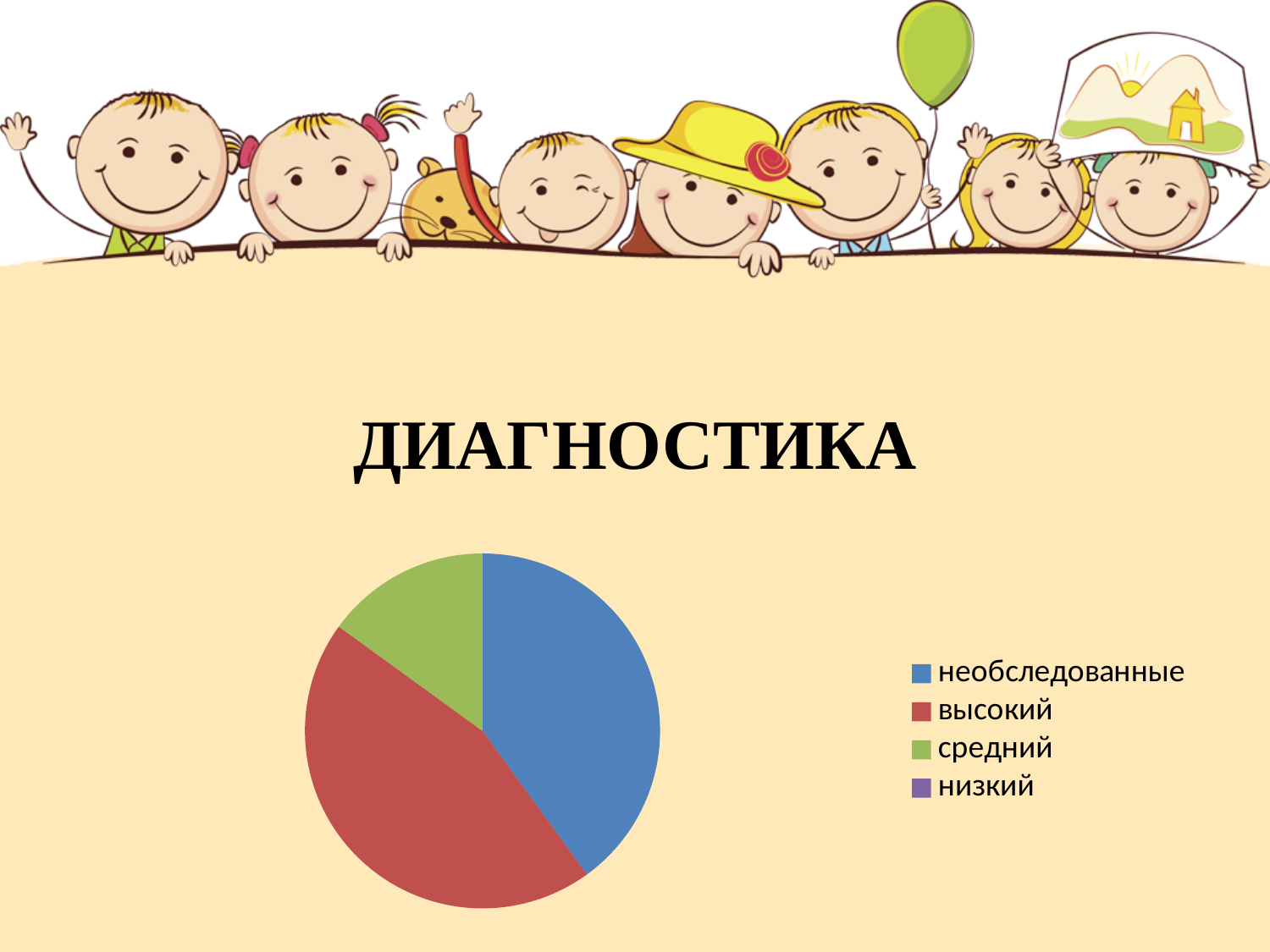
How many categories does the legend of the pie chart list? 4 What kind of chart is shown on the slide? pie chart Which is larger in the pie chart, the slice for необследованные or the slice for средний? необследованные What is the title shown above the pie chart? ДИАГНОСТИКА Which is larger in the pie chart, the slice for высокий or the slice for средний? высокий Which colour represents the category высокий in the pie chart? red